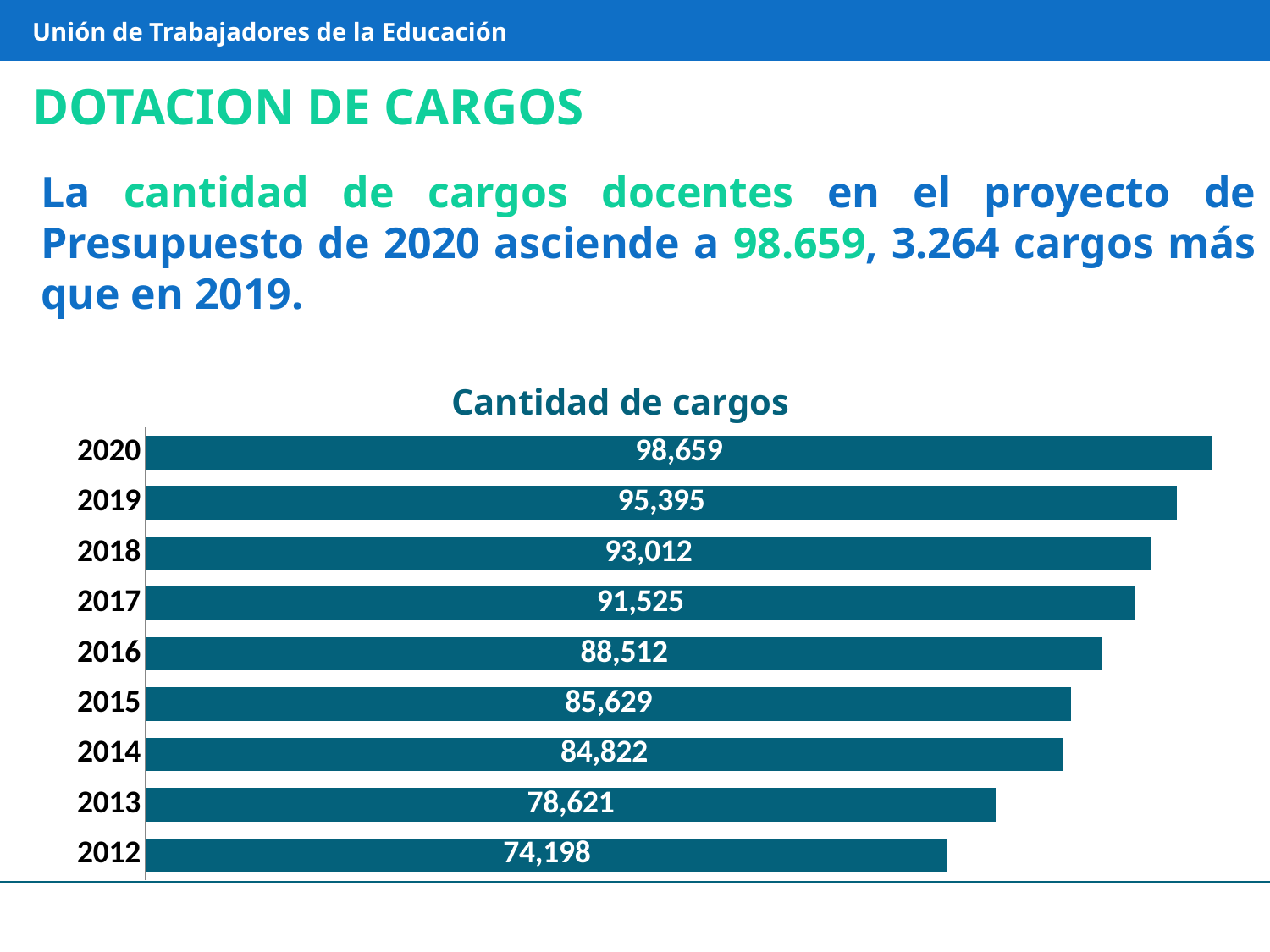
What is the value for 2020 in the Cantidad de cargos chart? 98,659 What is the title of the chart on the slide? Cantidad de cargos How many years are shown in the Cantidad de cargos chart? 9 What is the difference between the values for 2014 and 2013 in the Cantidad de cargos chart? 6,201 Which year has the highest value in the Cantidad de cargos chart? 2020 What is the difference between the values for 2020 and 2019 in the Cantidad de cargos chart? 3,264 What is the value for 2016 in the Cantidad de cargos chart? 88,512 Which is larger in the Cantidad de cargos chart, the value for 2015 or the value for 2017? 2017 What is the value for 2012 in the Cantidad de cargos chart? 74,198 Which year has the lowest value in the Cantidad de cargos chart? 2012 Do the values in the Cantidad de cargos chart rise or fall from 2012 to 2020? rise What kind of chart is the Cantidad de cargos chart? bar chart